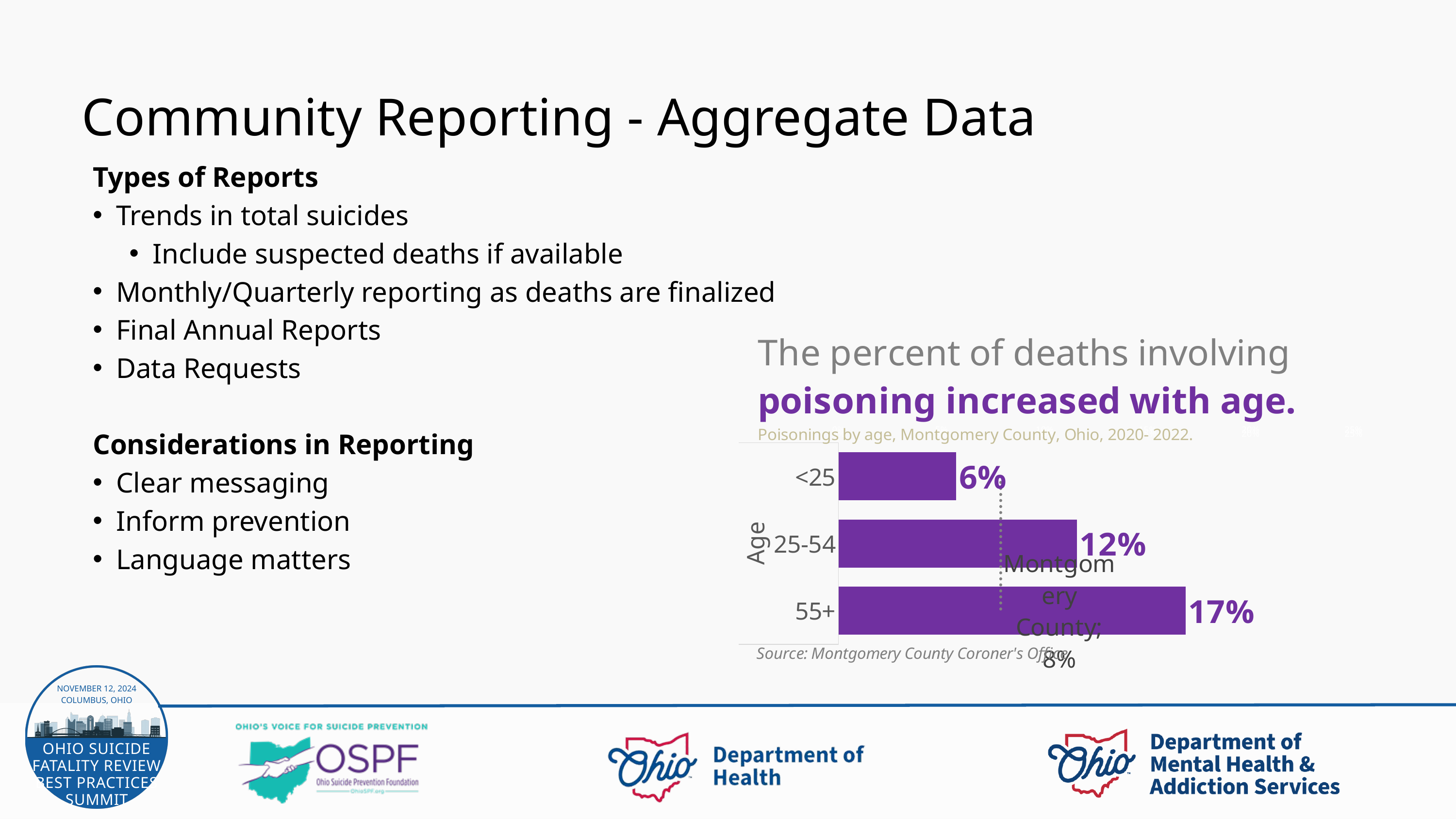
What percent of deaths involved poisoning for the 25-54 age group? 12% What is the difference in percentage points between the 55+ and <25 age groups? 11 What percent of deaths involved poisoning for the 55+ age group? 17% Which age group has a higher percent of deaths involving poisoning, 25-54 or 55+? 55+ What kind of chart is used to show poisonings by age? Bar chart Which age group has the lowest percent of deaths involving poisoning? <25 Which age group has the highest percent of deaths involving poisoning? 55+ What percent of deaths involved poisoning for the <25 age group? 6% What is the source cited for the poisonings by age chart? Montgomery County Coroner's Office What is the value of the Montgomery County reference line shown in the chart? 8% What is the difference in percentage points between the 25-54 and <25 age groups? 6 How many age groups are shown in the chart? 3